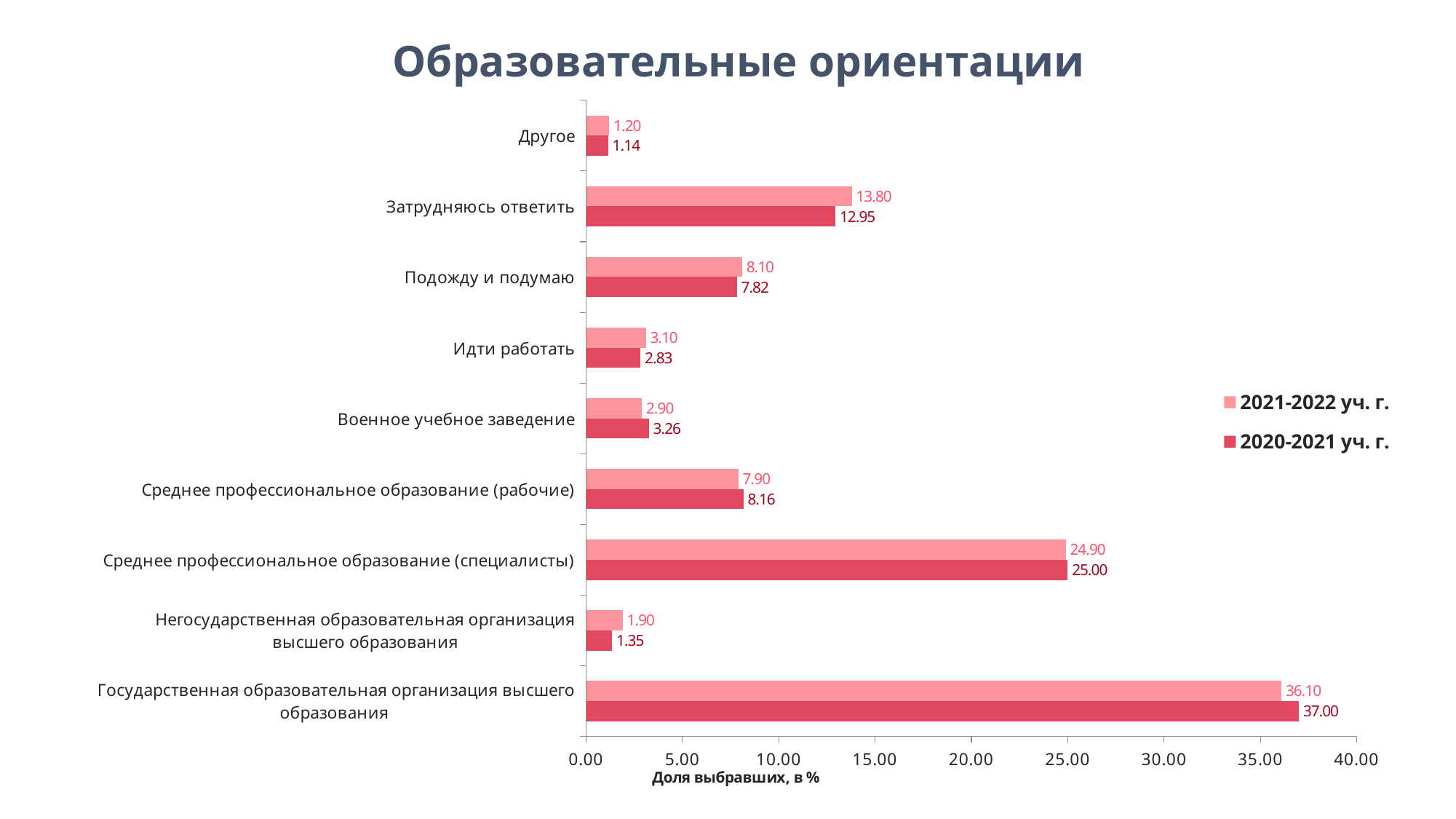
Is the 2021-2022 уч. г. value for "Среднее профессиональное образование (специалисты)" greater or less than 25.00? less What is the title of the chart? Образовательные ориентации For "Подожду и подумаю", which series has the larger value: 2021-2022 уч. г. or 2020-2021 уч. г.? 2021-2022 уч. г. What is the value for "Затрудняюсь ответить" in the 2021-2022 уч. г. series? 13.80 What is the difference between the 2020-2021 уч. г. and 2021-2022 уч. г. values for "Среднее профессиональное образование (специалисты)"? 0.10 What is the value for "Военное учебное заведение" in the 2020-2021 уч. г. series? 3.26 What type of chart is shown on the slide? bar chart How many series does the legend list? 2 Which category has the highest value in the 2021-2022 уч. г. series? Государственная образовательная организация высшего образования How many categories are shown on the chart? 9 What is the value for "Государственная образовательная организация высшего образования" in the 2020-2021 уч. г. series? 37.00 Which category has the lowest value in the 2020-2021 уч. г. series? Другое